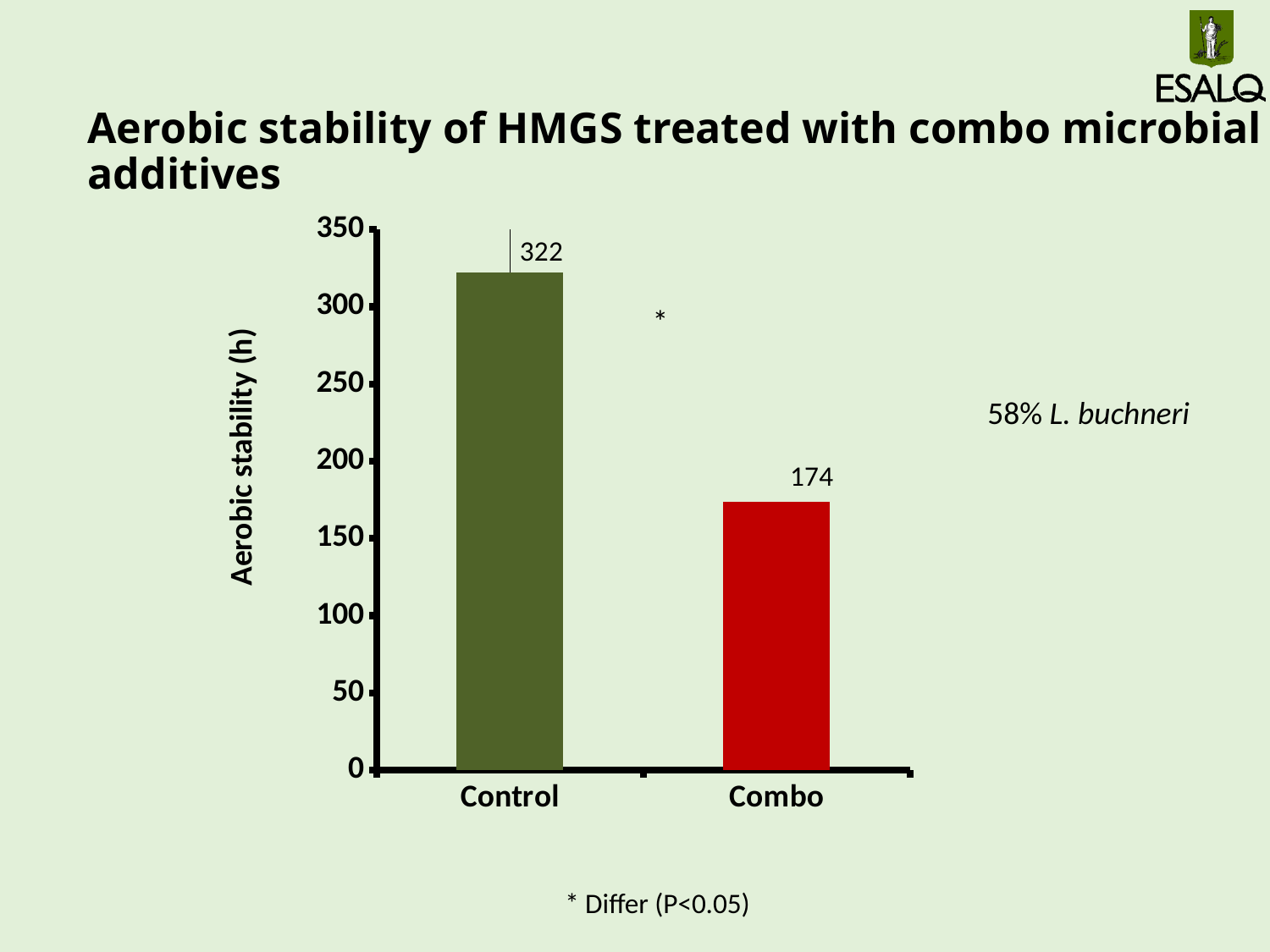
Which has a larger aerobic stability value, Control or Combo? Control What kind of chart is shown on the slide? bar chart How many categories are shown on the x axis? 2 What is the title of the slide? Aerobic stability of HMGS treated with combo microbial additives Is the value for Control greater or less than 300? greater What is the difference in aerobic stability between Control and Combo? 148 What is the aerobic stability value for Combo? 174 Which category has the lowest aerobic stability? Combo Which category has the highest aerobic stability? Control What is the label of the y axis? Aerobic stability (h) What is the aerobic stability value for Control? 322 Is the value for Combo greater or less than 200? less